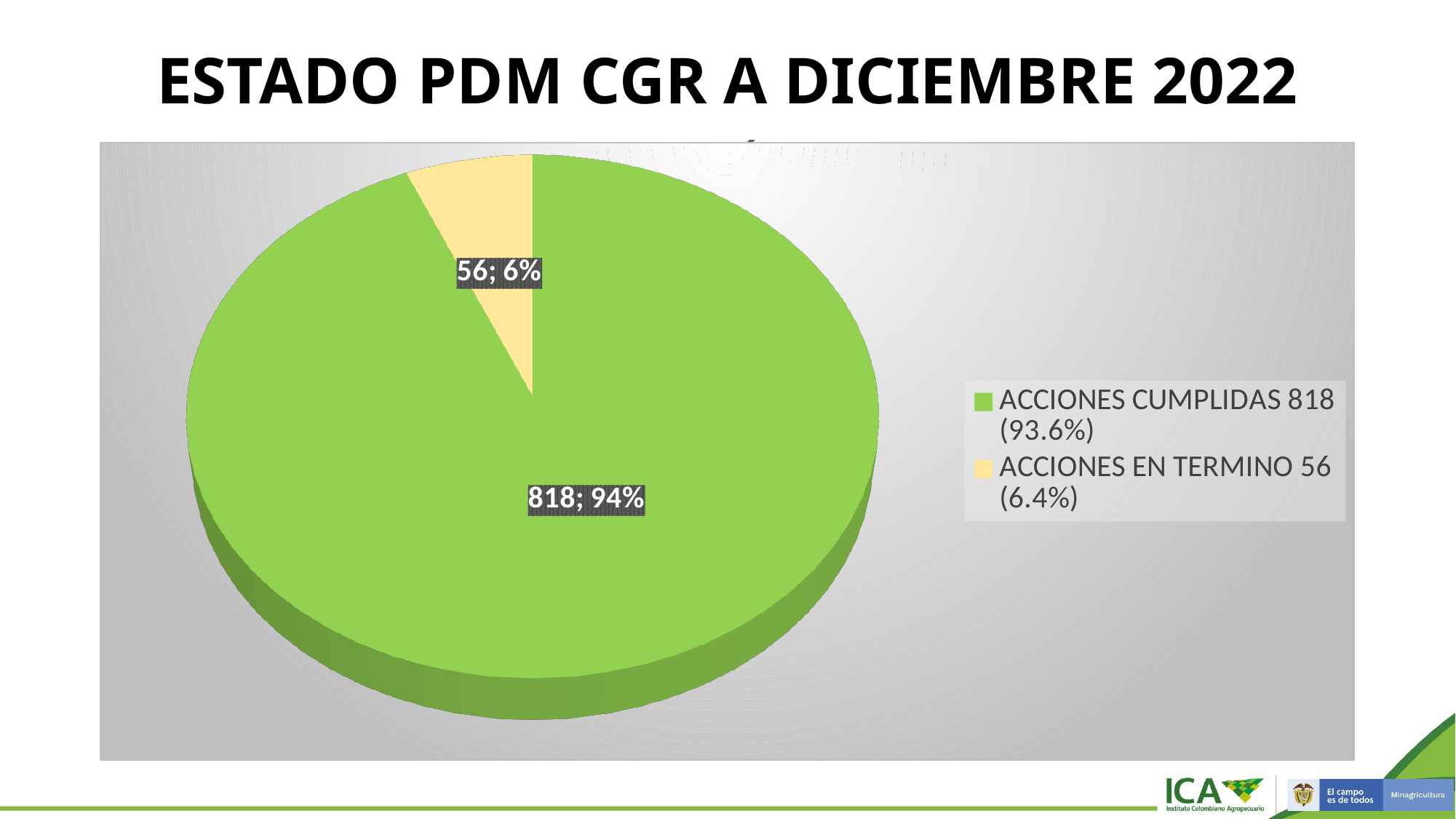
What is the total of the two values shown in the pie chart? 874 What percentage share of the pie does ACCIONES EN TERMINO represent according to its data label? 6% What type of chart is shown on the slide? Pie chart What is the difference between the values for ACCIONES CUMPLIDAS and ACCIONES EN TERMINO? 762 What is the value for ACCIONES CUMPLIDAS? 818 What percentage share of the pie does ACCIONES CUMPLIDAS represent according to its data label? 94% What colour is the slice for ACCIONES EN TERMINO? Light yellow What is the title of the slide containing the chart? ESTADO PDM CGR A DICIEMBRE 2022 What is the value for ACCIONES EN TERMINO? 56 How many categories does the pie chart have? 2 Which category has the smallest slice of the pie? ACCIONES EN TERMINO Which category has the largest slice of the pie? ACCIONES CUMPLIDAS